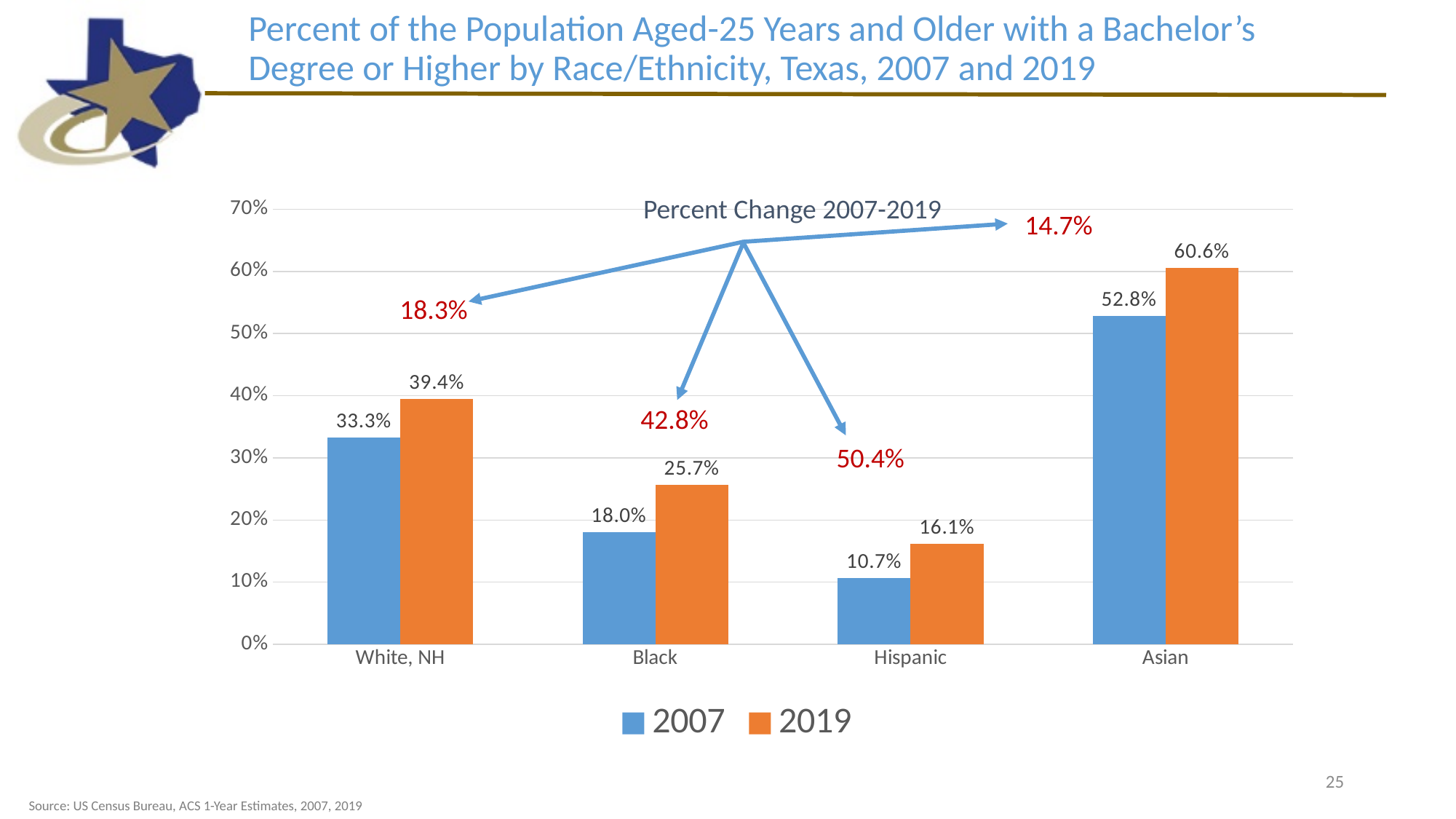
What is the difference between the 2019 and 2007 values for White, NH? 6.1% Which colour represents the 2019 series in the legend? Orange What kind of chart is shown on the slide? Bar chart What is the value for Asian in 2019? 60.6% Which category has the highest value in 2007? Asian What is the value for Hispanic in 2007? 10.7% Which category has the lowest value in 2019? Hispanic Which is larger: the 2019 value for Black or the 2007 value for White, NH? 2007 value for White, NH How many race/ethnicity categories are shown on the x axis? 4 What is the percent change 2007-2019 annotated for Hispanic? 50.4% What is the value for Black in 2019? 25.7% How many series does the legend list? 2